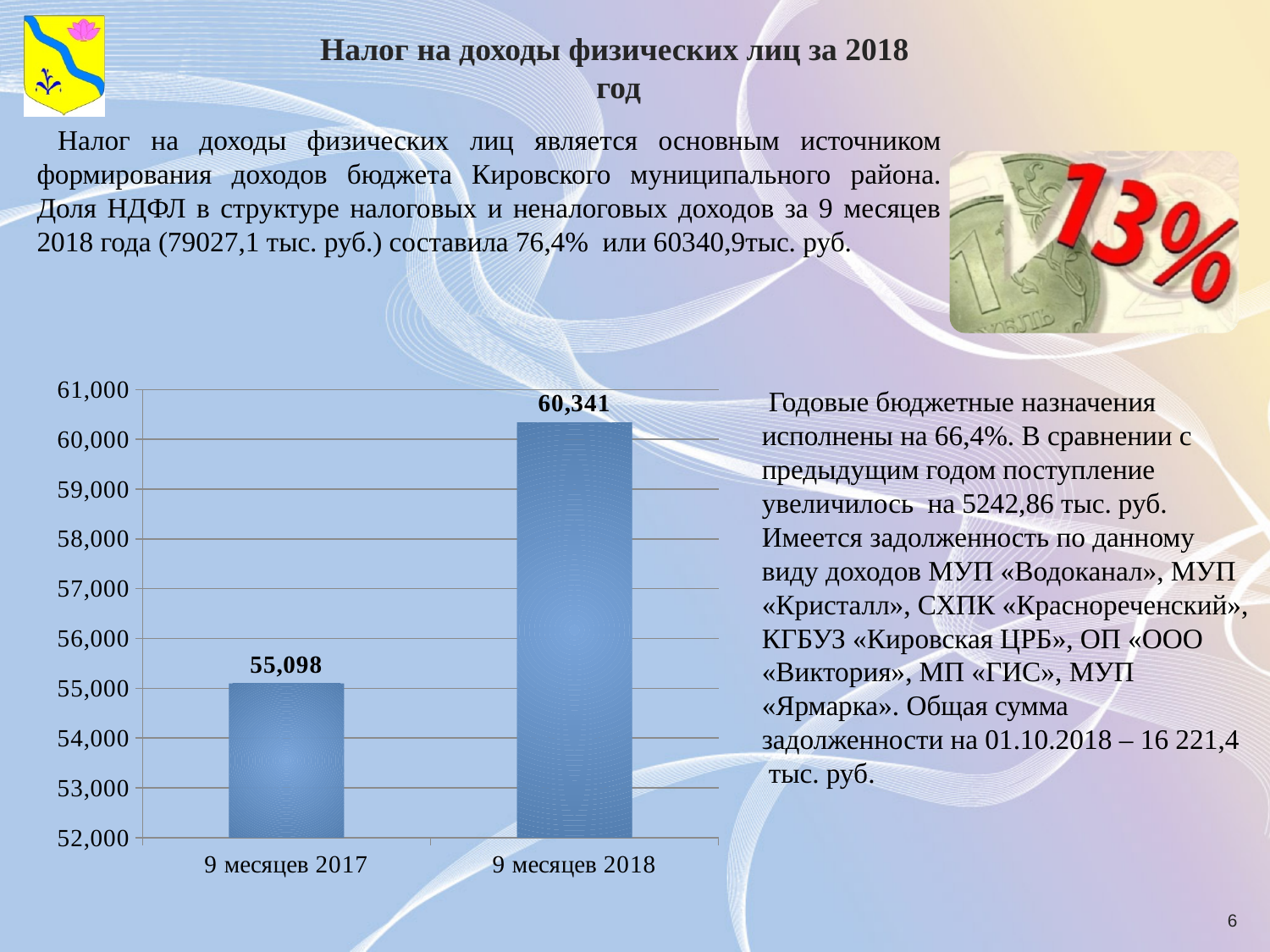
What is the difference between the values for 9 месяцев 2018 and 9 месяцев 2017? 5,243 Which category has the highest value? 9 месяцев 2018 How many categories are shown on the x axis of the chart? 2 Which category has the lowest value? 9 месяцев 2017 What is the value for 9 месяцев 2018? 60,341 What is the value for 9 месяцев 2017? 55,098 Is the value for 9 месяцев 2017 greater or less than 56,000? less What is the lowest value shown on the chart's vertical axis? 52,000 Which is larger, the value for 9 месяцев 2017 or for 9 месяцев 2018? 9 месяцев 2018 Do the values rise or fall from 9 месяцев 2017 to 9 месяцев 2018? rise Is the value for 9 месяцев 2018 greater or less than 60,000? greater What kind of chart is shown on the slide? bar chart